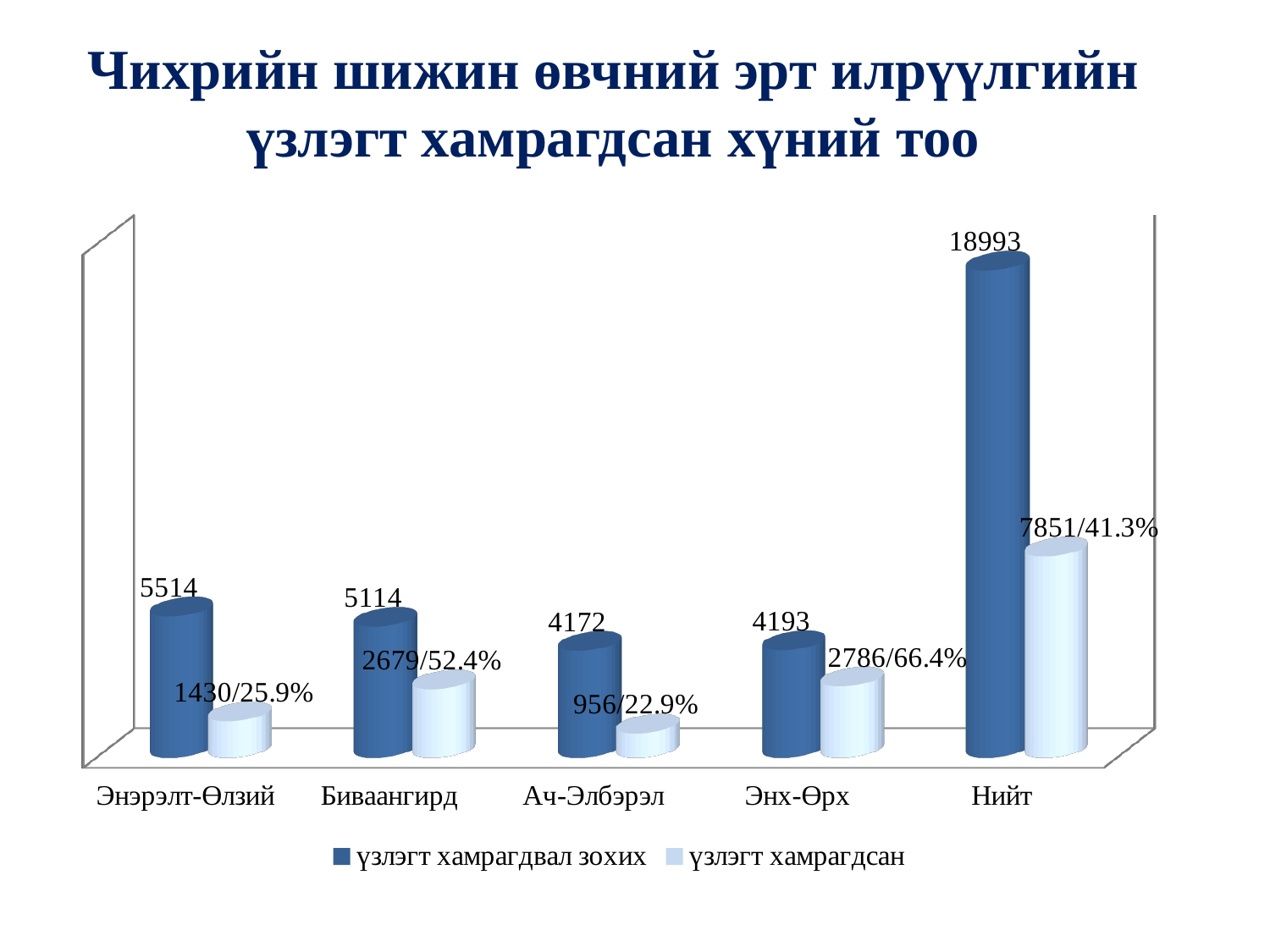
Which has a larger "үзлэгт хамрагдсан" value, Биваангирд or Энх-Өрх? Энх-Өрх How many categories are shown on the x axis? 5 What is the difference between "үзлэгт хамрагдвал зохих" for Энэрэлт-Өлзий and for Биваангирд? 400 What is the difference between "үзлэгт хамрагдвал зохих" and "үзлэгт хамрагдсан" for Энэрэлт-Өлзий? 4084 Which category has the highest value for "үзлэгт хамрагдвал зохих"? Нийт What kind of chart is shown on the slide? Bar chart What is the value of "үзлэгт хамрагдвал зохих" for Нийт? 18993 What data label is shown for "үзлэгт хамрагдсан" for Ач-Элбэрэл? 956/22.9% Which category has the lowest value for "үзлэгт хамрагдсан"? Ач-Элбэрэл What data label is shown for "үзлэгт хамрагдсан" for Энх-Өрх? 2786/66.4% How many series does the legend list? 2 What is the value of "үзлэгт хамрагдвал зохих" for Биваангирд? 5114